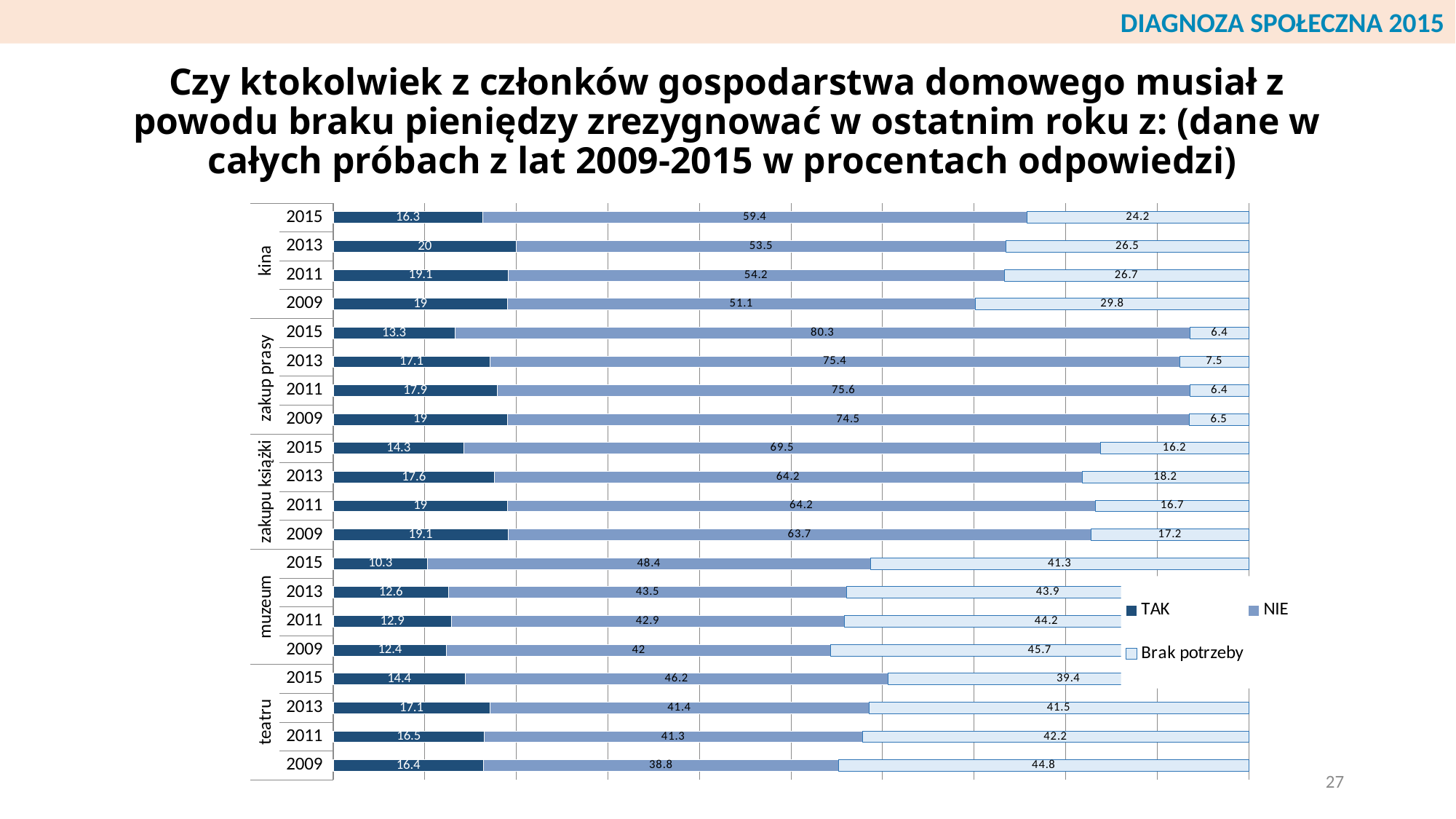
Does the Brak potrzeby value for kina rise or fall from 2009 to 2015? fall What is the Brak potrzeby value for teatru in 2015? 39.4 What is the difference between the NIE and TAK values for kina in 2015? 43.1 What is the TAK value for kina in 2015? 16.3 How many stacked bars are shown in the chart? 20 What is the total of the stacked bar for kina in 2015? 99.9 What is the Brak potrzeby value for muzeum in 2009? 45.7 What is the NIE value for zakup prasy in 2015? 80.3 How many series does the legend list? 3 Which bar has the highest NIE value in the chart? zakup prasy 2015 For teatru in 2009, which is larger: the NIE value or the Brak potrzeby value? Brak potrzeby Which bar has the lowest TAK value in the chart? muzeum 2015